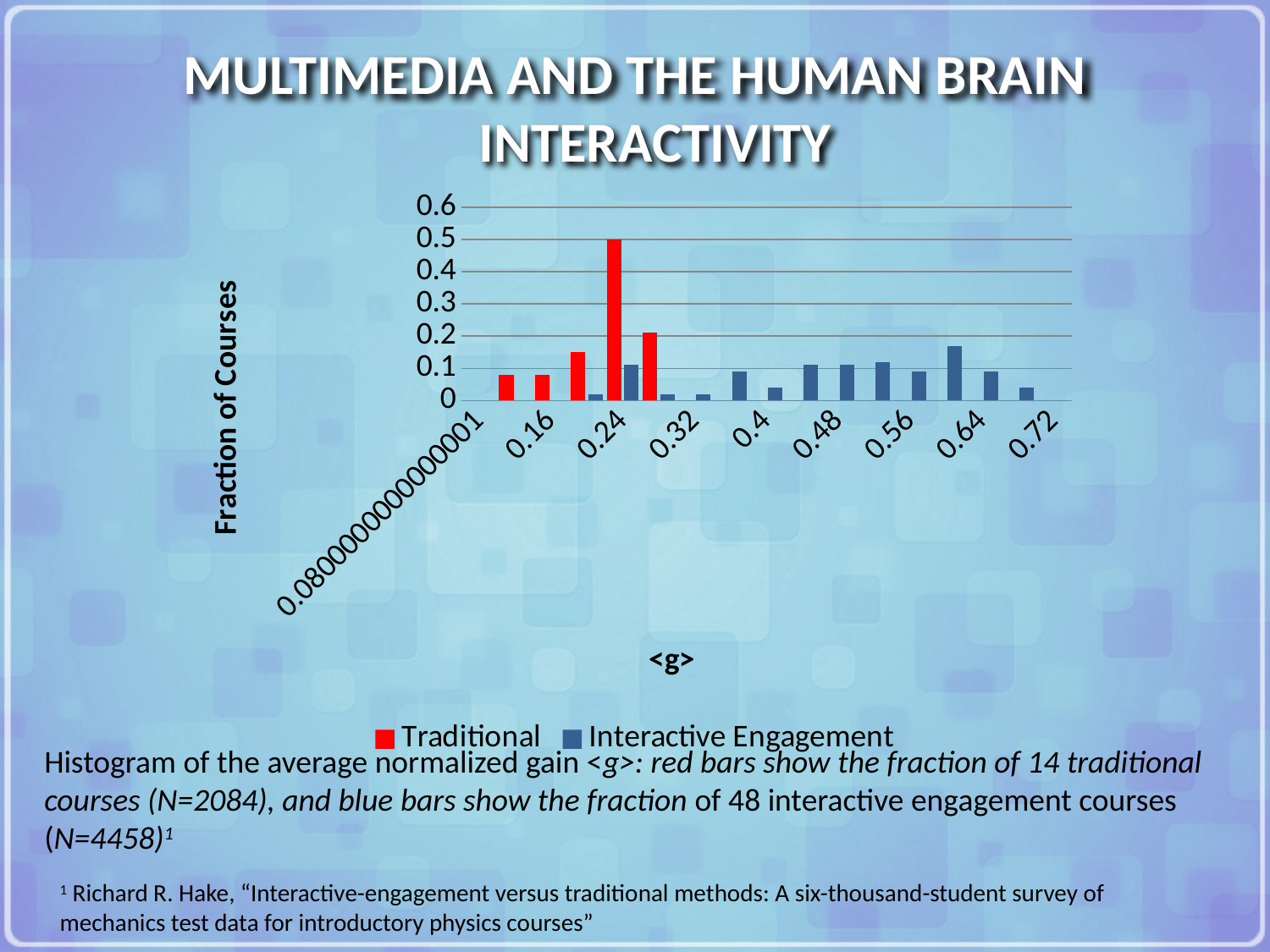
What value does the tallest Traditional bar reach on the vertical axis? 0.5 Is the value for the Traditional bar at 0.16 greater or less than 0.2? less How many series does the legend list? 2 What are the two series named in the legend? Traditional and Interactive Engagement What kind of chart is shown on the slide? bar chart Is the tallest Traditional bar greater or less than 0.4? greater Which series contains the tallest bar on the chart? Traditional Is the tallest Interactive Engagement bar greater or less than 0.1? greater What is the title of the vertical axis? Fraction of Courses What is the highest value shown on the vertical axis? 0.6 Which series has bars extending to the higher <g> values on the right side of the chart? Interactive Engagement